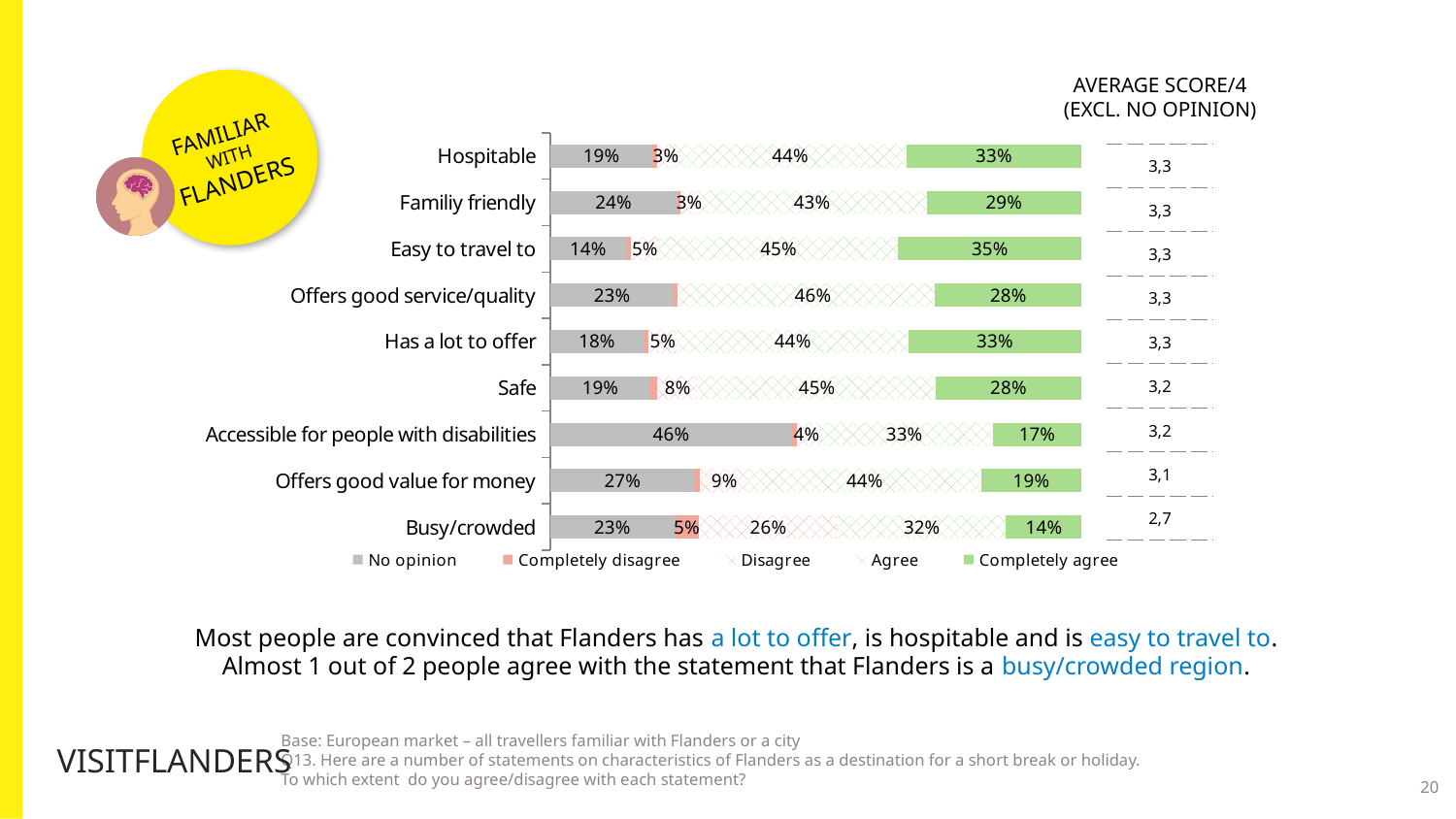
Which has a larger 'Completely agree' share: 'Familiy friendly' or 'Has a lot to offer'? Has a lot to offer Which statement has the highest 'Completely agree' share? Easy to travel to What percentage of respondents completely agree that Flanders is easy to travel to? 35% What type of chart is shown on the slide? Stacked bar chart What is the 'No opinion' share for the statement 'Accessible for people with disabilities'? 46% How many series does the legend list? 5 Which statement has the highest 'No opinion' share? Accessible for people with disabilities What is the 'Agree' share for the statement 'Busy/crowded'? 32% What is the difference in percentage points between the 'Completely agree' share for 'Hospitable' and for 'Busy/crowded'? 19 percentage points How many statements (categories) are shown in the chart? 9 What is the average score (out of 4) shown for 'Busy/crowded'? 2,7 Which statement has the lowest 'Completely agree' share? Busy/crowded